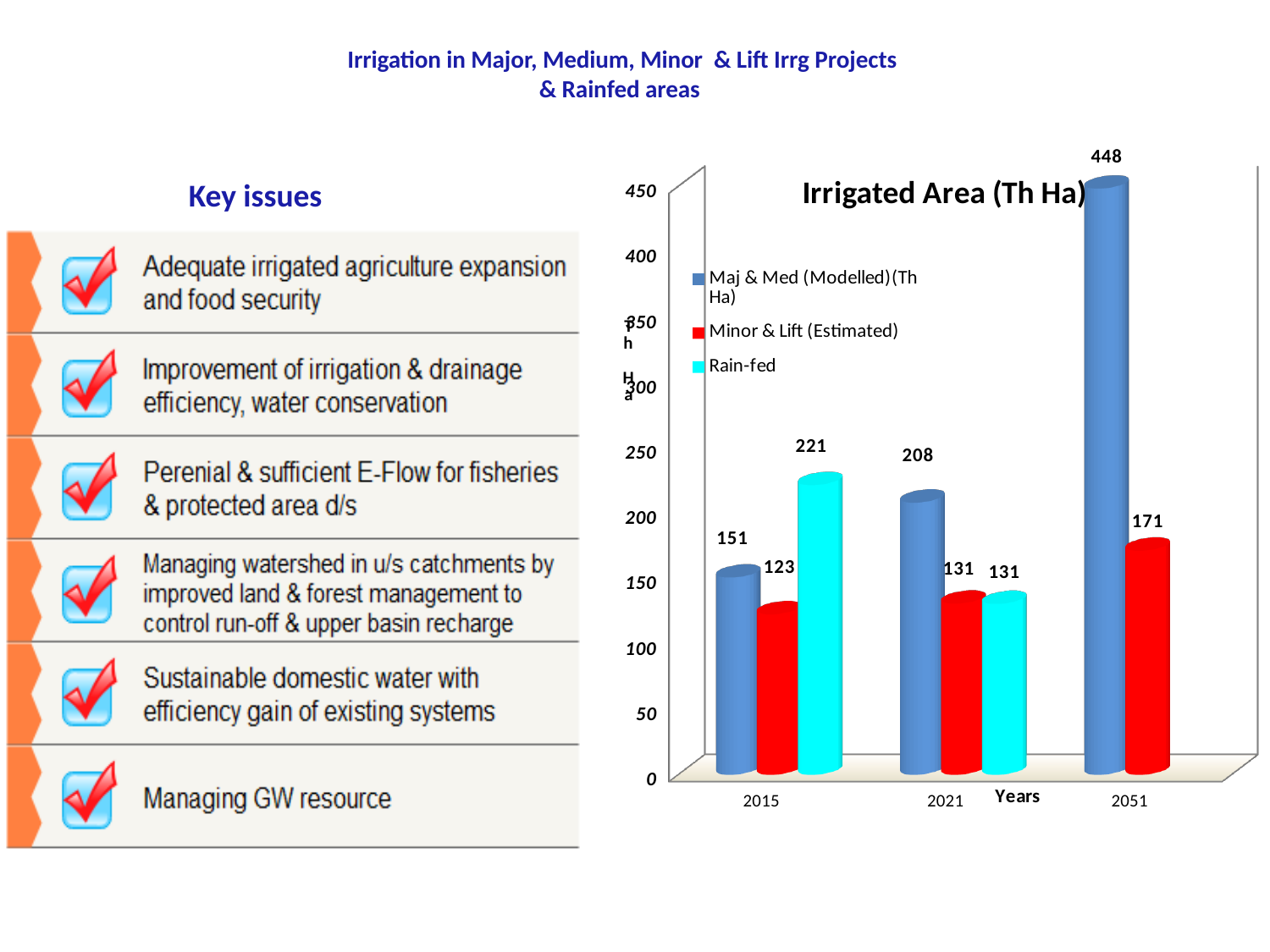
What is the value for Maj & Med (Modelled) in 2015? 151 What is the value for Rain-fed in 2015? 221 What kind of chart is shown? Bar chart In which year is the Minor & Lift (Estimated) value lowest? 2015 How many series does the legend list? 3 Which is larger in 2015: Maj & Med (Modelled) or Rain-fed? Rain-fed In which year is the Maj & Med (Modelled) value highest? 2051 What is the value for Maj & Med (Modelled) in 2051? 448 What is the difference between the Maj & Med (Modelled) values for 2051 and 2021? 240 How many years are shown on the x axis? 3 Does the Maj & Med (Modelled) value rise or fall from 2015 to 2051? Rise What is the value for Minor & Lift (Estimated) in 2021? 131